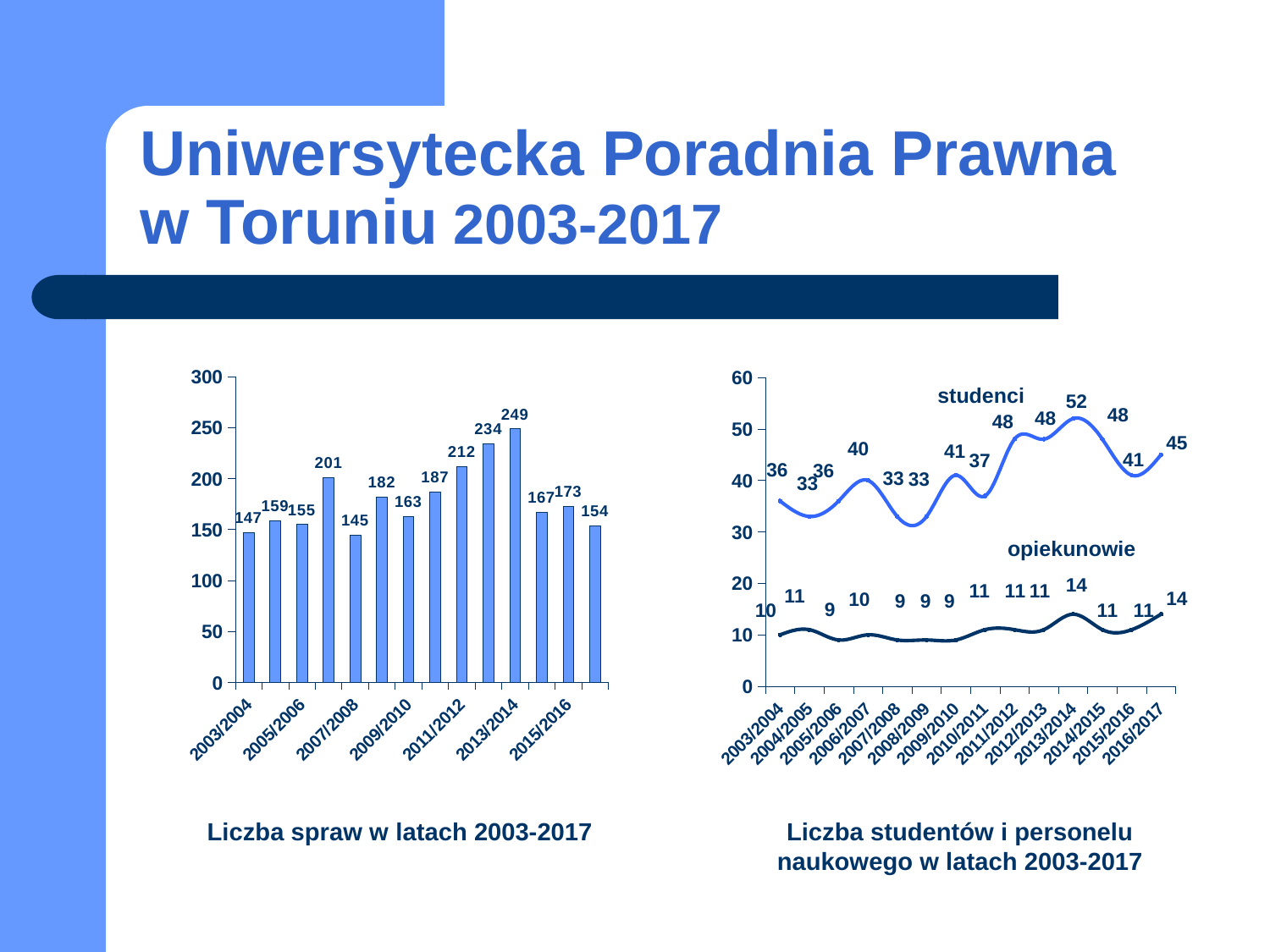
In the left chart (Liczba spraw w latach 2003-2017), which year has the lowest value? 2007/2008 In the left chart (Liczba spraw w latach 2003-2017), what is the difference between the values for 2013/2014 and 2015/2016? 76 In the left chart (Liczba spraw w latach 2003-2017), what is the value for 2013/2014? 249 In the right chart (Liczba studentów i personelu naukowego), how many series are plotted? 2 What kind of chart is the left chart (Liczba spraw w latach 2003-2017)? bar chart In the right chart (Liczba studentów i personelu naukowego), which is larger: studenci in 2006/2007 or studenci in 2007/2008? 2006/2007 In the left chart (Liczba spraw w latach 2003-2017), how many bars are plotted? 14 In the right chart (Liczba studentów i personelu naukowego), what is the difference between studenci and opiekunowie in 2016/2017? 31 In the right chart (Liczba studentów i personelu naukowego), what is the value for opiekunowie in 2016/2017? 14 In the right chart (Liczba studentów i personelu naukowego), what is the value for studenci in 2013/2014? 52 In the left chart (Liczba spraw w latach 2003-2017), what is the value for 2003/2004? 147 In the right chart (Liczba studentów i personelu naukowego), in which year does the studenci series reach its highest value? 2013/2014